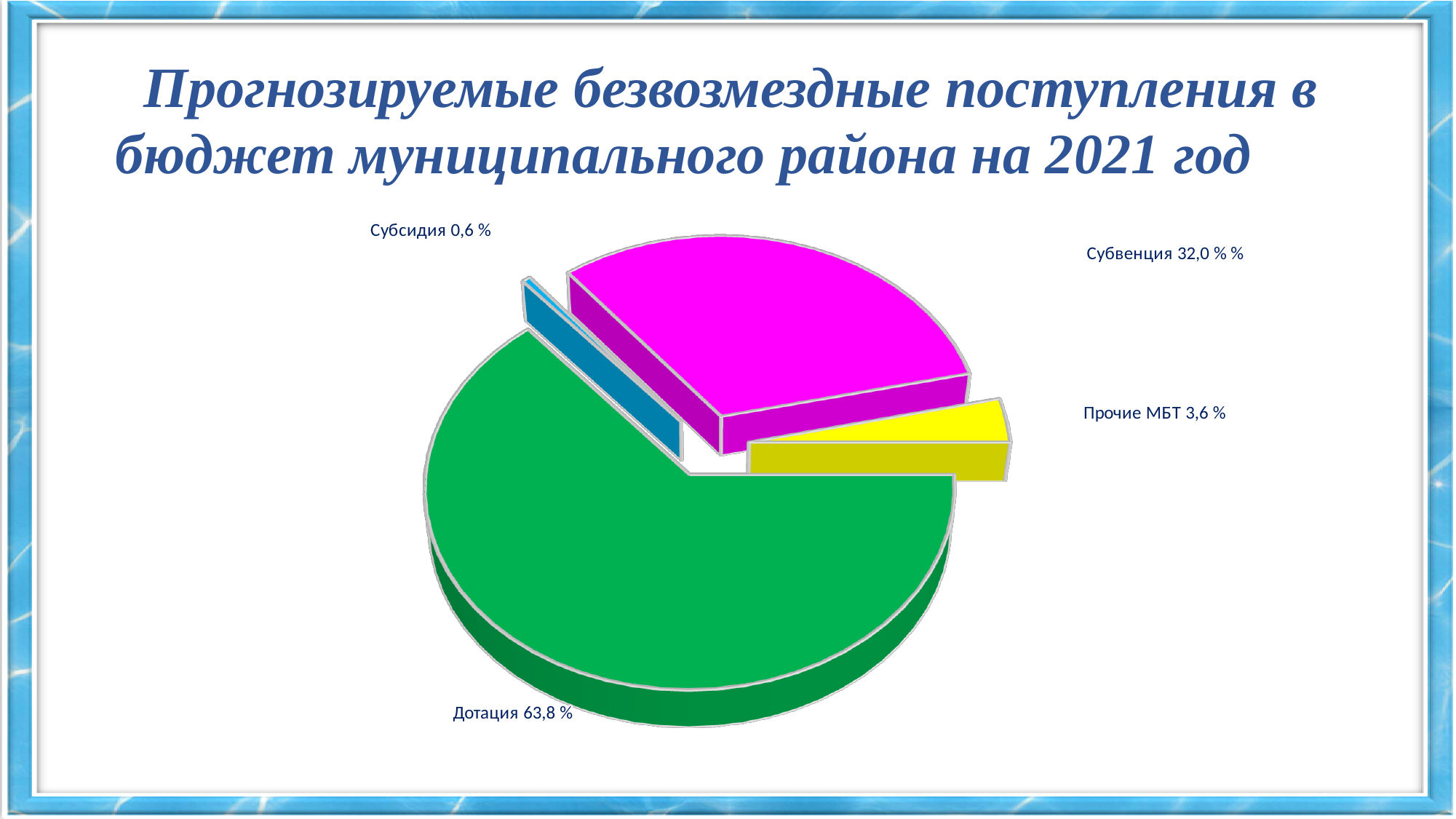
What kind of chart is shown on the slide? pie chart What colour is the Субвенция slice in the pie chart? magenta What colour is the Дотация slice in the pie chart? green How many slices does the pie chart have? 4 Which is larger in the pie chart, Прочие МБТ or Субсидия? Прочие МБТ What share does Субсидия have in the pie chart? 0,6 % What is the difference in percentage points between Дотация and Субвенция? 31,8 What share does Прочие МБТ have in the pie chart? 3,6 % Which slice of the pie chart is the smallest? Субсидия What share does Дотация have in the pie chart? 63,8 % What share does Субвенция have in the pie chart? 32,0 % Which slice of the pie chart is the largest? Дотация